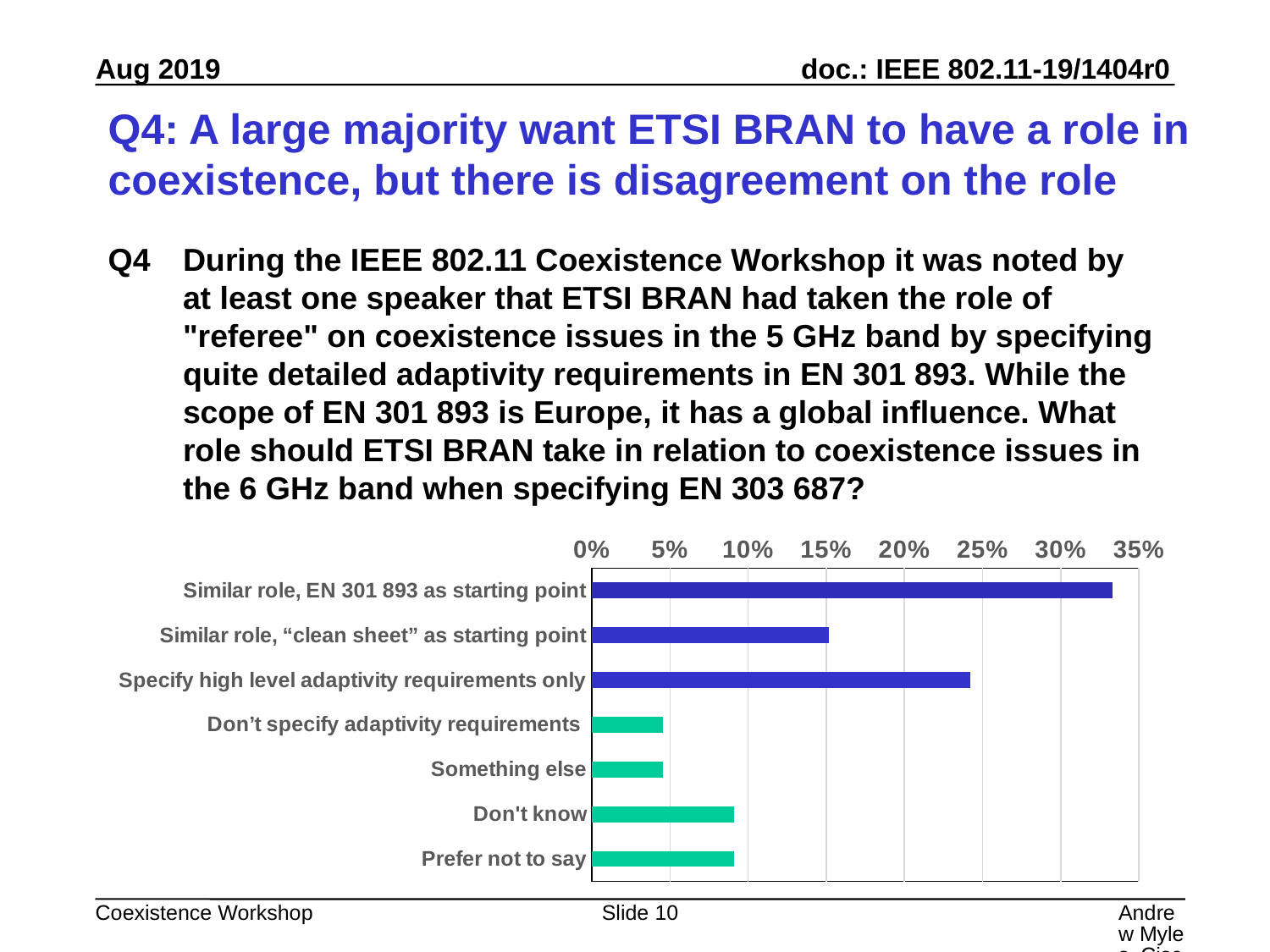
What kind of chart is shown on the slide? bar chart Is the value for "Similar role, EN 301 893 as starting point" greater or less than 30%? greater What is the highest percentage tick shown on the chart's axis? 35% Which is larger: the value for "Specify high level adaptivity requirements only" or the value for "Similar role, “clean sheet” as starting point"? Specify high level adaptivity requirements only Which response option has the highest value in the chart? Similar role, EN 301 893 as starting point Which is larger: the value for "Don't know" or the value for "Something else"? Don't know Is the value for "Specify high level adaptivity requirements only" greater or less than 20%? greater How many categories (response options) are plotted in the chart? 7 Is the value for "Don't know" greater or less than 5%? greater